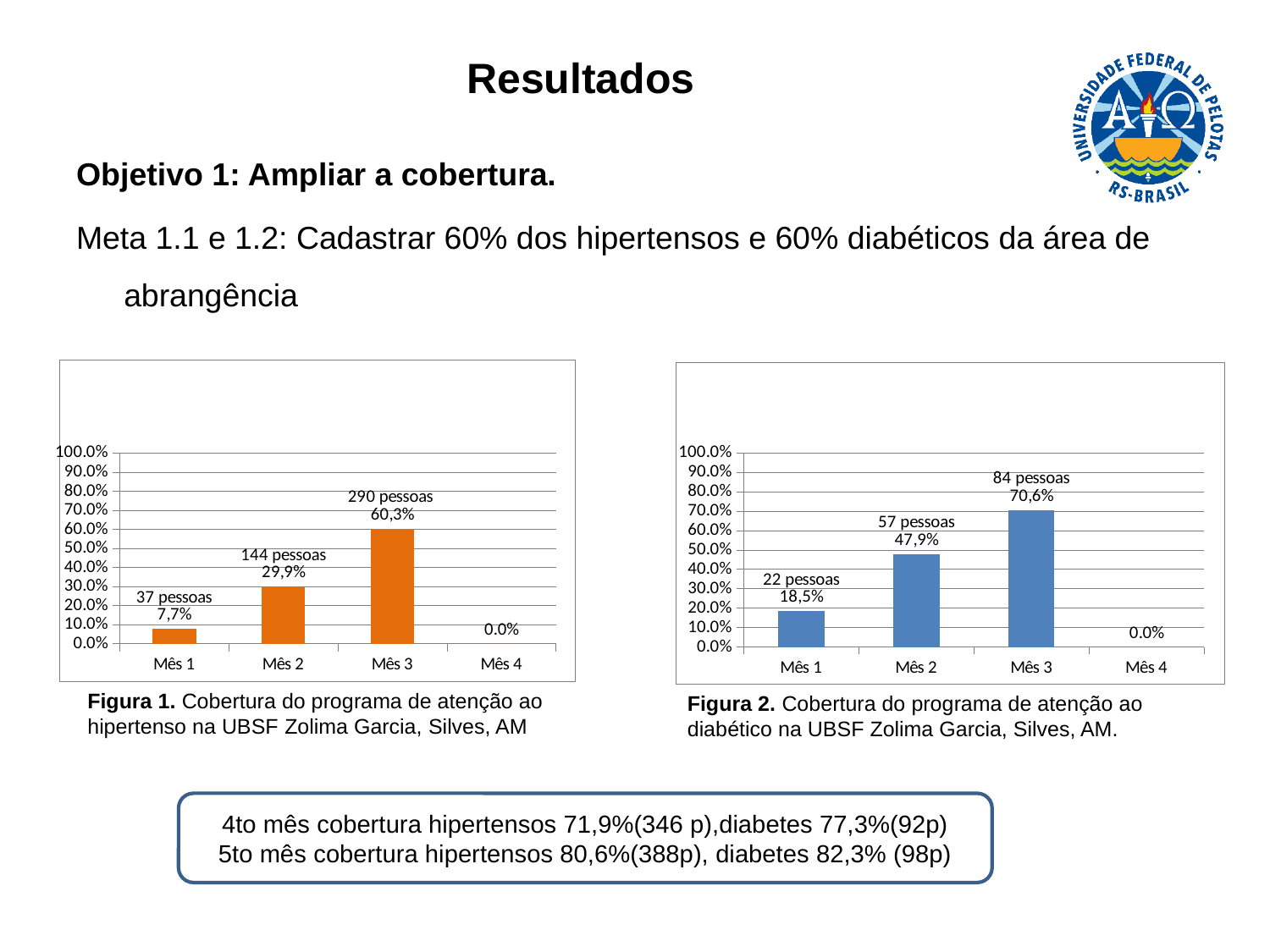
In Figura 2 (right chart), what is the difference in the number of people between Mês 2 and Mês 1? 35 pessoas In Figura 2 (right chart), is the value for Mês 3 greater or less than 60.0%? greater Which is larger: the Mês 2 coverage in Figura 1 (left chart) or the Mês 2 coverage in Figura 2 (right chart)? Figura 2 (47,9%) In Figura 1 (left chart), what is the coverage percentage shown for Mês 3? 60,3% In Figura 2 (right chart), what is the coverage percentage shown for Mês 1? 18,5% In Figura 2 (right chart), how many people are labelled for Mês 3? 84 pessoas How many month categories are shown on the x axis of Figura 1 (left chart)? 4 In Figura 1 (left chart), how many people are labelled for Mês 2? 144 pessoas In Figura 1 (left chart), which month has the highest coverage? Mês 3 What type of chart is Figura 2 (right chart)? Bar chart In Figura 1 (left chart), what is the difference in coverage percentage between Mês 3 and Mês 2? 30,4% In Figura 2 (right chart), which month has the lowest non-zero coverage? Mês 1